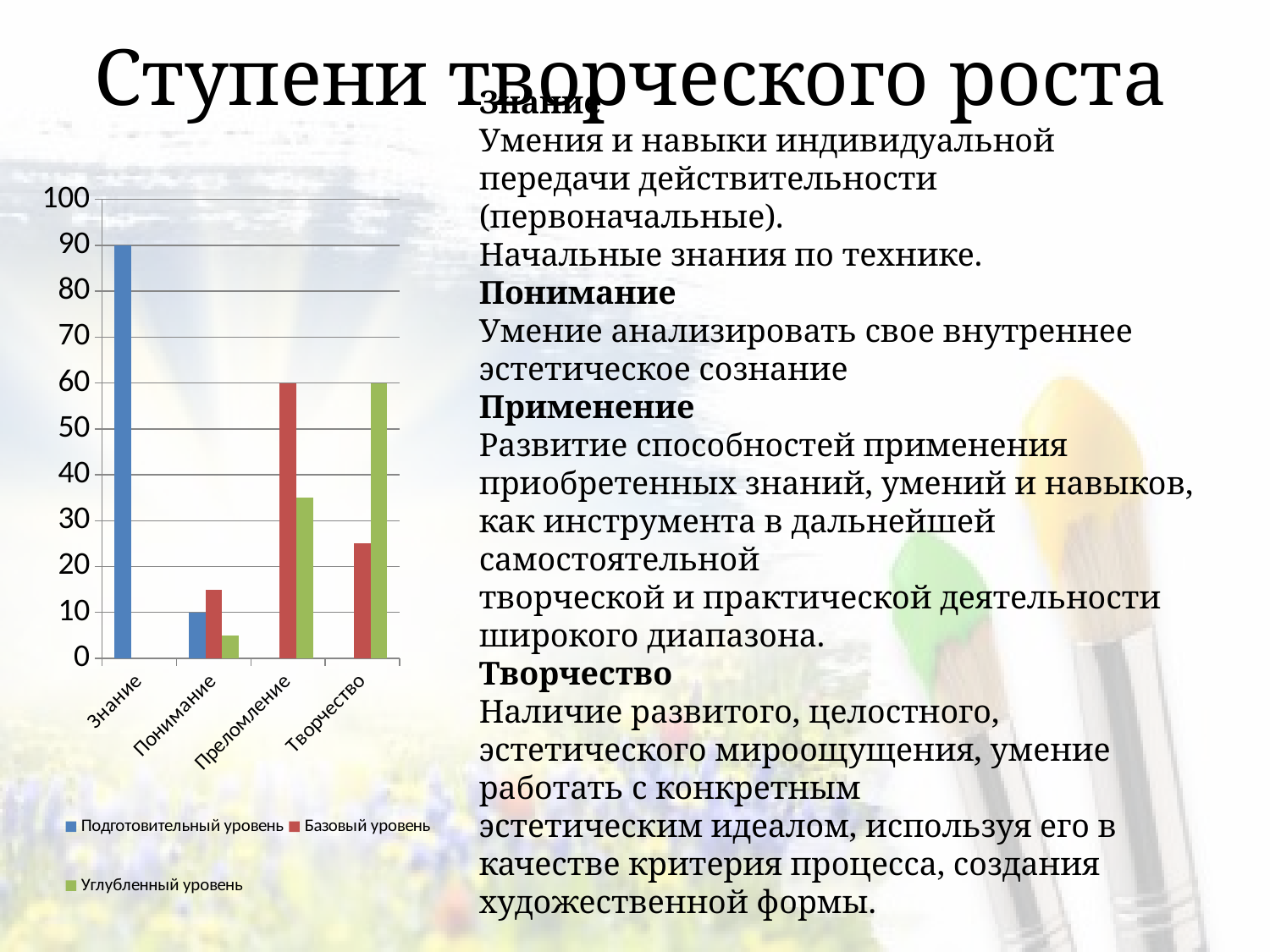
How many series does the chart legend list? 3 Which series is shown in red in the chart? Базовый уровень Which is larger for Творчество: Базовый уровень or Углубленный уровень? Углубленный уровень Which category has the highest value for Подготовительный уровень? Знание What is the value of Подготовительный уровень for Понимание? 10 What is the value of Базовый уровень for Преломление? 60 Which category has the lowest value for Углубленный уровень? Понимание What is the value of Подготовительный уровень for Знание? 90 Is the value of Углубленный уровень for Преломление greater or less than 30? greater What kind of chart is shown on the slide? bar chart How many categories are shown on the x axis of the chart? 4 What is the value of Углубленный уровень for Творчество? 60